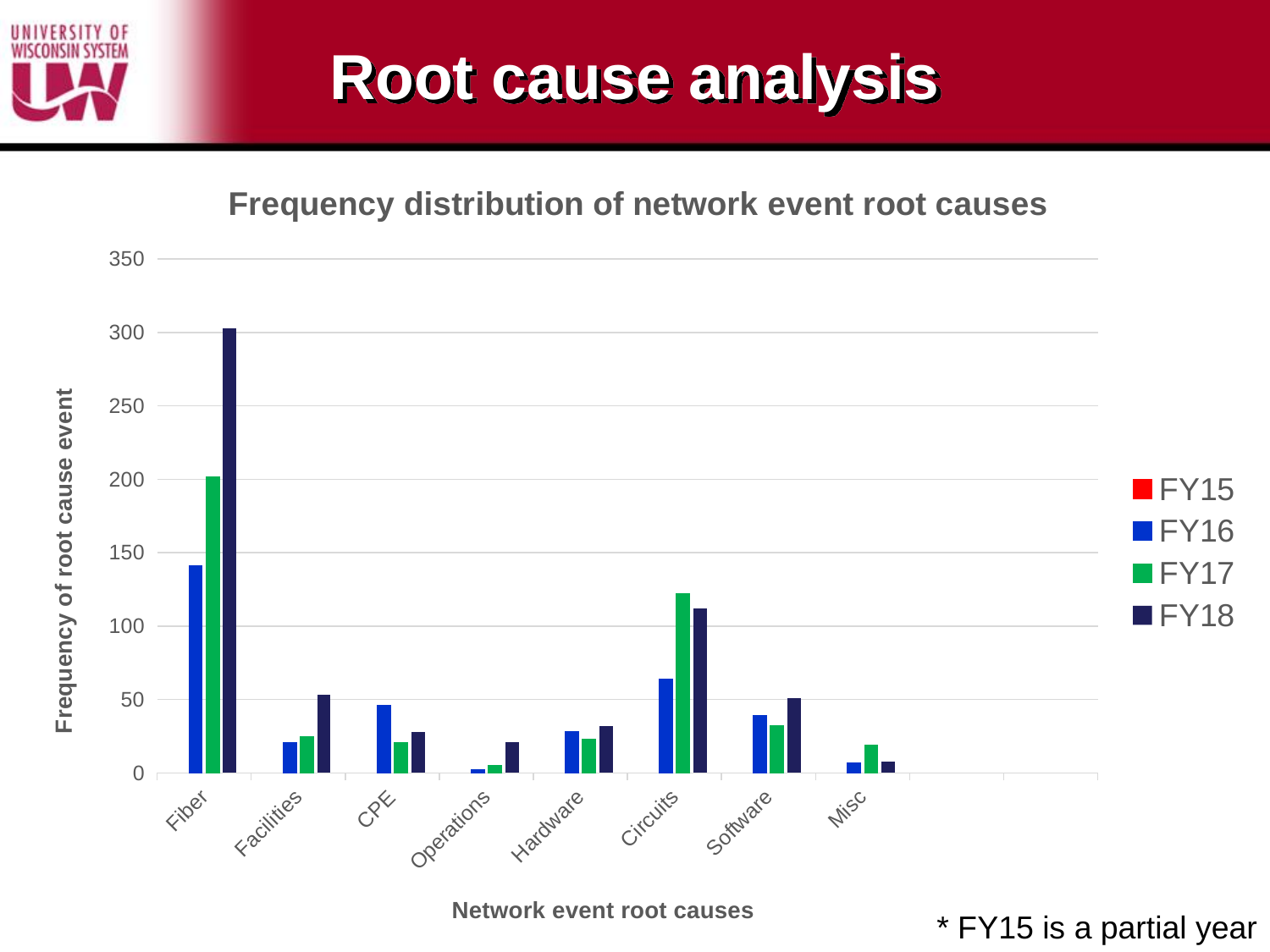
What kind of chart is shown on the slide? bar chart What is the title of the chart? Frequency distribution of network event root causes Which root cause category has the highest FY18 bar? Fiber Which root cause category has the lowest FY16 bar? Operations Is the FY17 value for Circuits greater or less than 100? greater How many network event root cause categories are shown on the x axis? 8 Is the FY18 value for Fiber greater or less than 250? greater Is the FY17 value for Fiber greater or less than 150? greater For CPE, which is larger: the FY16 value or the FY17 value? FY16 What is the label of the vertical axis? Frequency of root cause event How many series does the legend list? 4